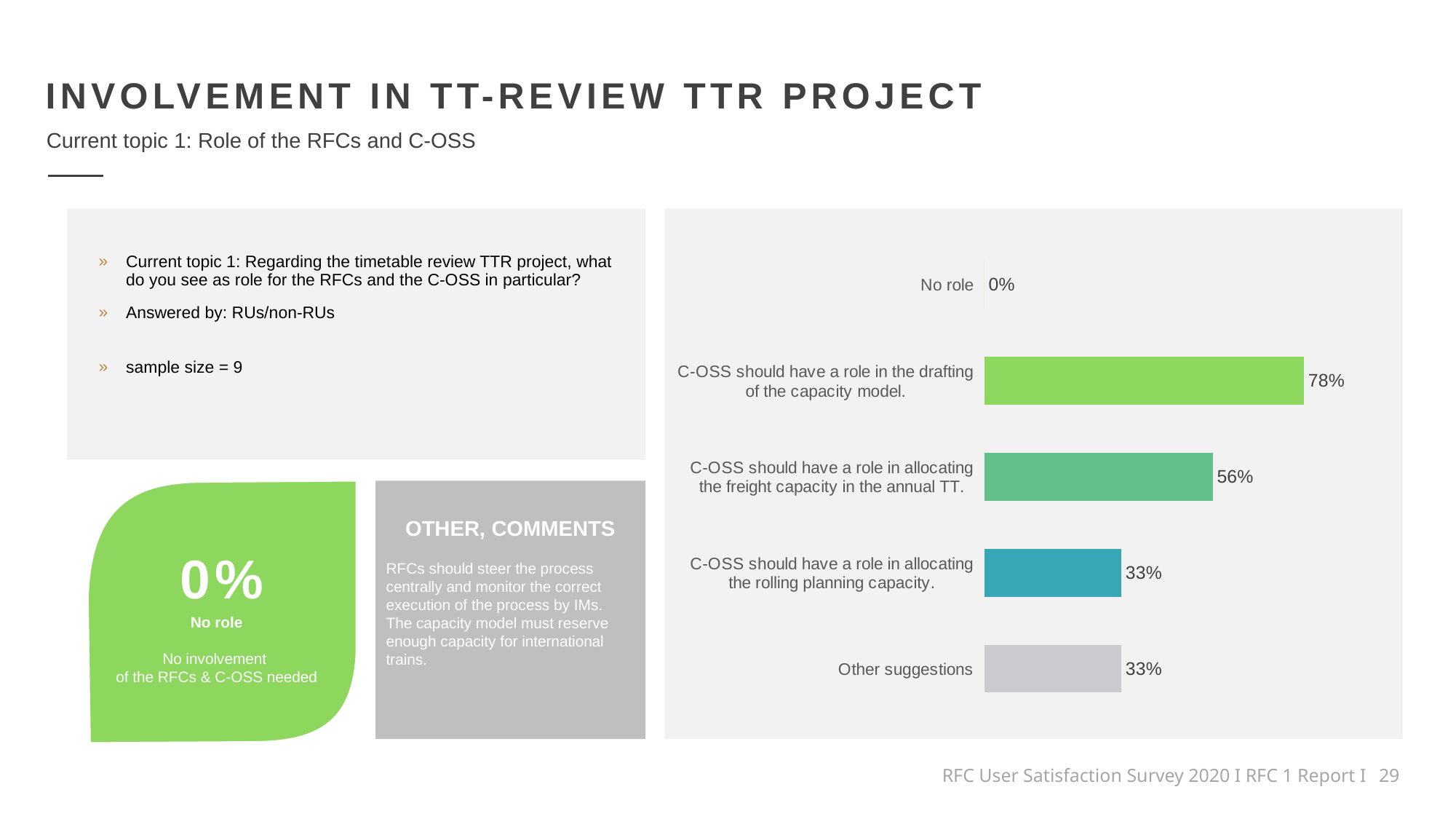
Which is larger: the value for "C-OSS should have a role in allocating the freight capacity in the annual TT." or the value for "Other suggestions"? C-OSS should have a role in allocating the freight capacity in the annual TT. What kind of chart is shown on the slide? bar chart What is the value for "C-OSS should have a role in allocating the freight capacity in the annual TT."? 56% What colour is the bar for "Other suggestions"? grey What is the value for "C-OSS should have a role in the drafting of the capacity model."? 78% How many categories does the bar chart show? 5 What is the difference between the value for "C-OSS should have a role in the drafting of the capacity model." and the value for "C-OSS should have a role in allocating the freight capacity in the annual TT."? 22% What is the value for "Other suggestions"? 33% Which category has the lowest value? No role What is the value for "C-OSS should have a role in allocating the rolling planning capacity."? 33% Which category has the highest value? C-OSS should have a role in the drafting of the capacity model. What is the value for "No role"? 0%